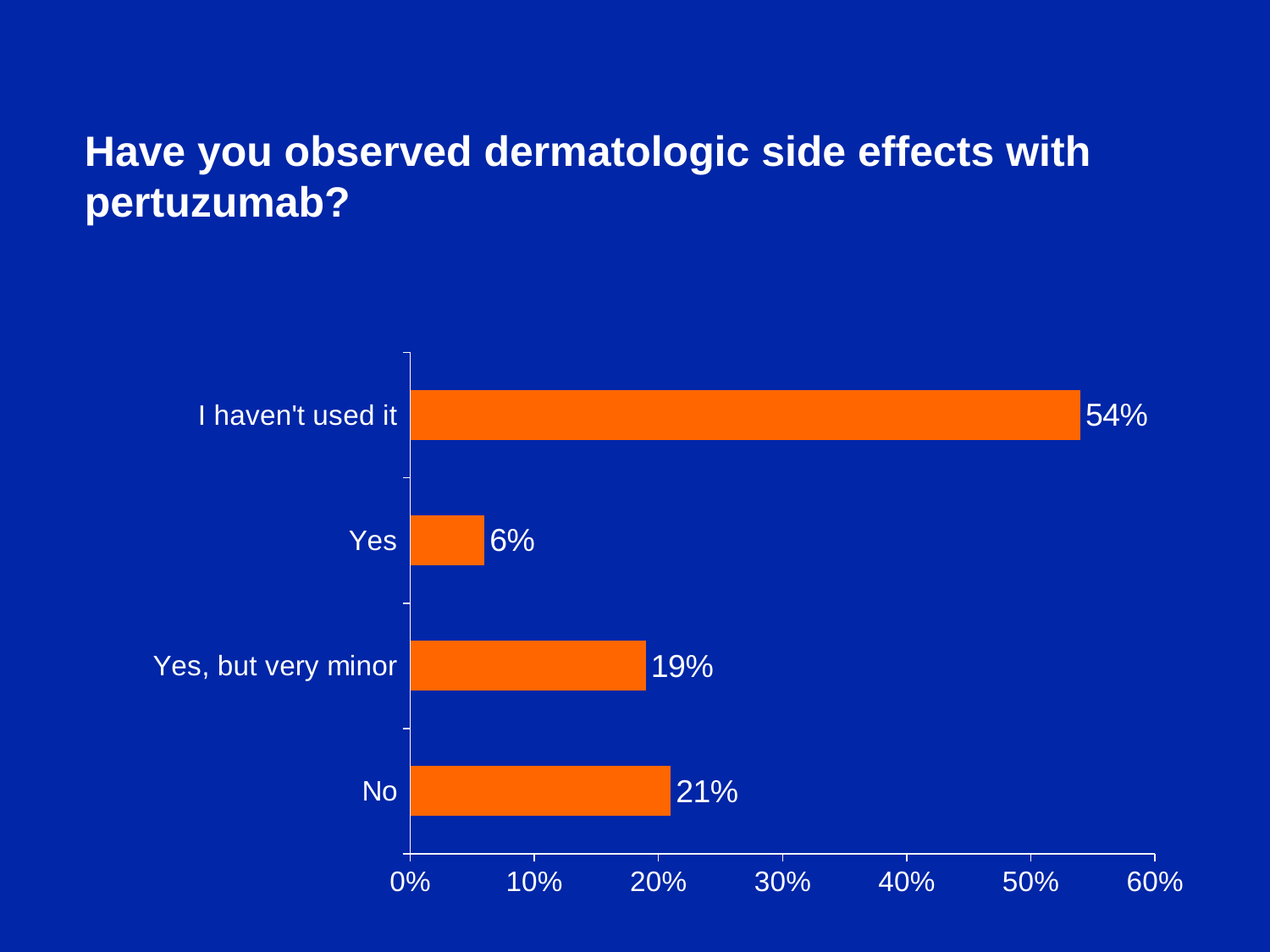
Which response category has the highest percentage? I haven't used it What percentage of respondents answered "I haven't used it"? 54% What is the title of the slide? Have you observed dermatologic side effects with pertuzumab? What percentage of respondents answered "Yes"? 6% What percentage of respondents answered "Yes, but very minor"? 19% What is the difference in percentage points between "No" and "Yes, but very minor"? 2 What percentage of respondents answered "No"? 21% What kind of chart is shown on the slide? Bar chart What is the difference in percentage points between "I haven't used it" and "No"? 33 Which is larger, the percentage for "Yes, but very minor" or for "Yes"? Yes, but very minor Which response category has the lowest percentage? Yes How many response categories are shown in the chart? 4